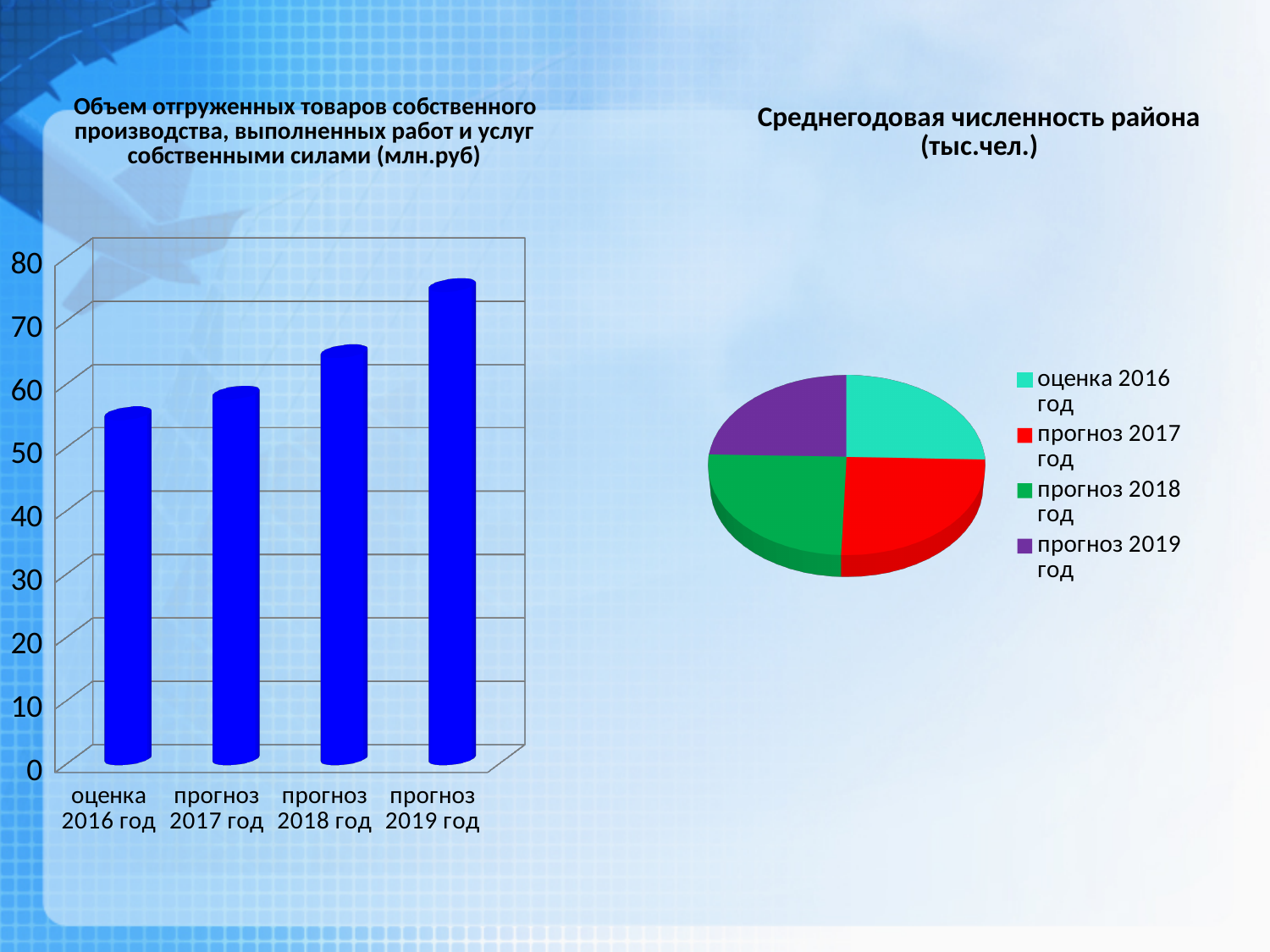
In the left bar chart, is the value for прогноз 2018 год greater or less than 70? less In the left bar chart, how many bars are plotted? 4 In the left bar chart, which category has the highest value? прогноз 2019 год In the left bar chart, is the value for оценка 2016 год greater or less than 50? greater In the right pie chart, how many slices does the pie have? 4 In the right pie chart, how many entries does the legend list? 4 In the left bar chart, is the value for прогноз 2019 год greater or less than 70? greater What kind of chart is the left chart titled "Объем отгруженных товаров собственного производства, выполненных работ и услуг собственными силами (млн.руб)"? bar chart In the left bar chart, do the values rise or fall from оценка 2016 год to прогноз 2019 год? rise In the left bar chart, which is larger: the value for прогноз 2018 год or the value for оценка 2016 год? прогноз 2018 год In the left bar chart, which category has the lowest value? оценка 2016 год What kind of chart is the right chart titled "Среднегодовая численность района (тыс.чел.)"? pie chart